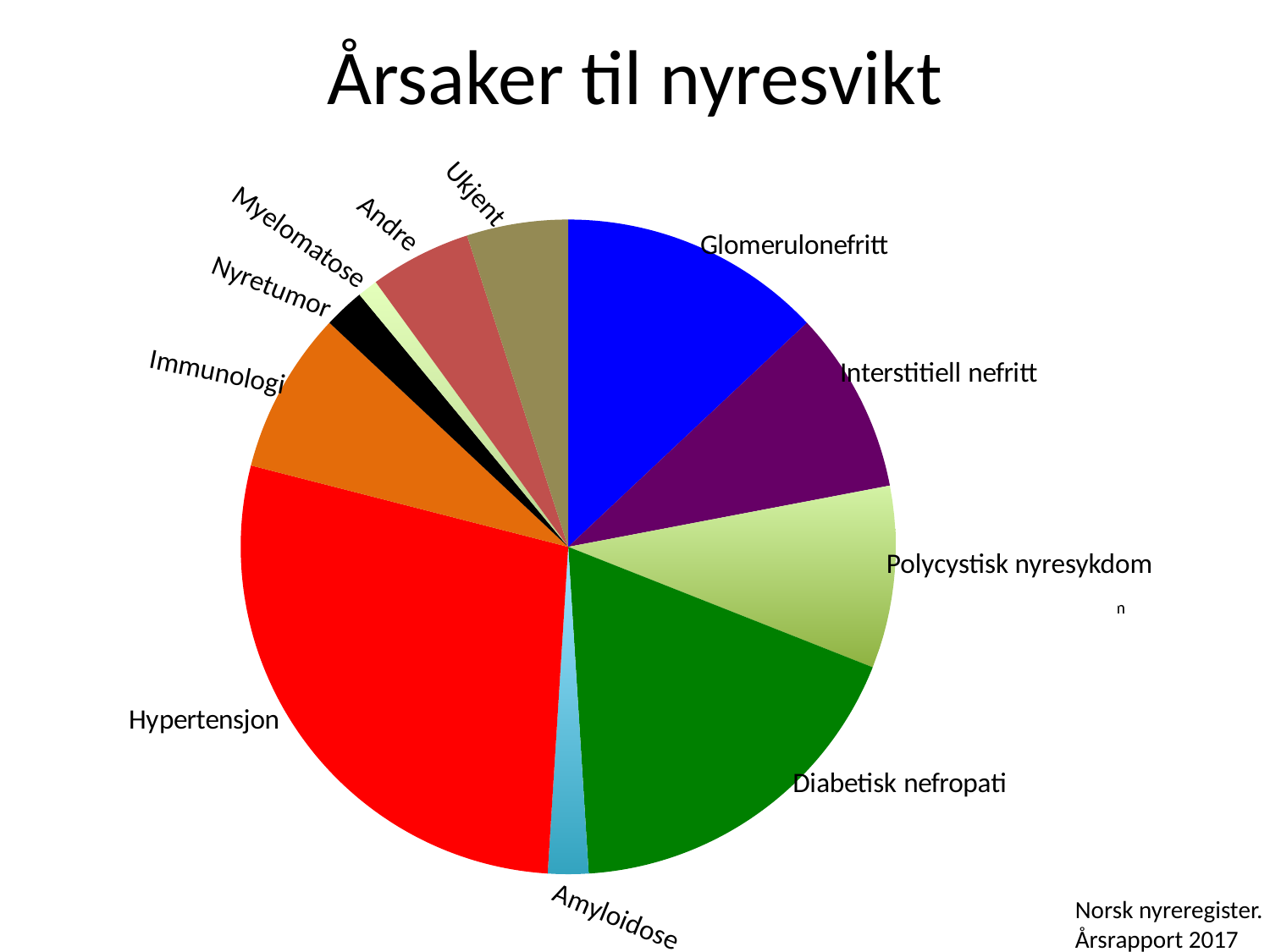
How many slices does the pie chart have? 11 Which slice is larger, Immunologi or Nyretumor? Immunologi Which cause has the smallest slice of the pie? Myelomatose Which cause has the largest slice of the pie? Hypertensjon What colour is the Hypertensjon slice? red What kind of chart is shown on the slide? pie chart Which slice is larger, Interstitiell nefritt or Ukjent? Interstitiell nefritt Which slice is larger, Hypertensjon or Diabetisk nefropati? Hypertensjon What is the title of the chart? Årsaker til nyresvikt